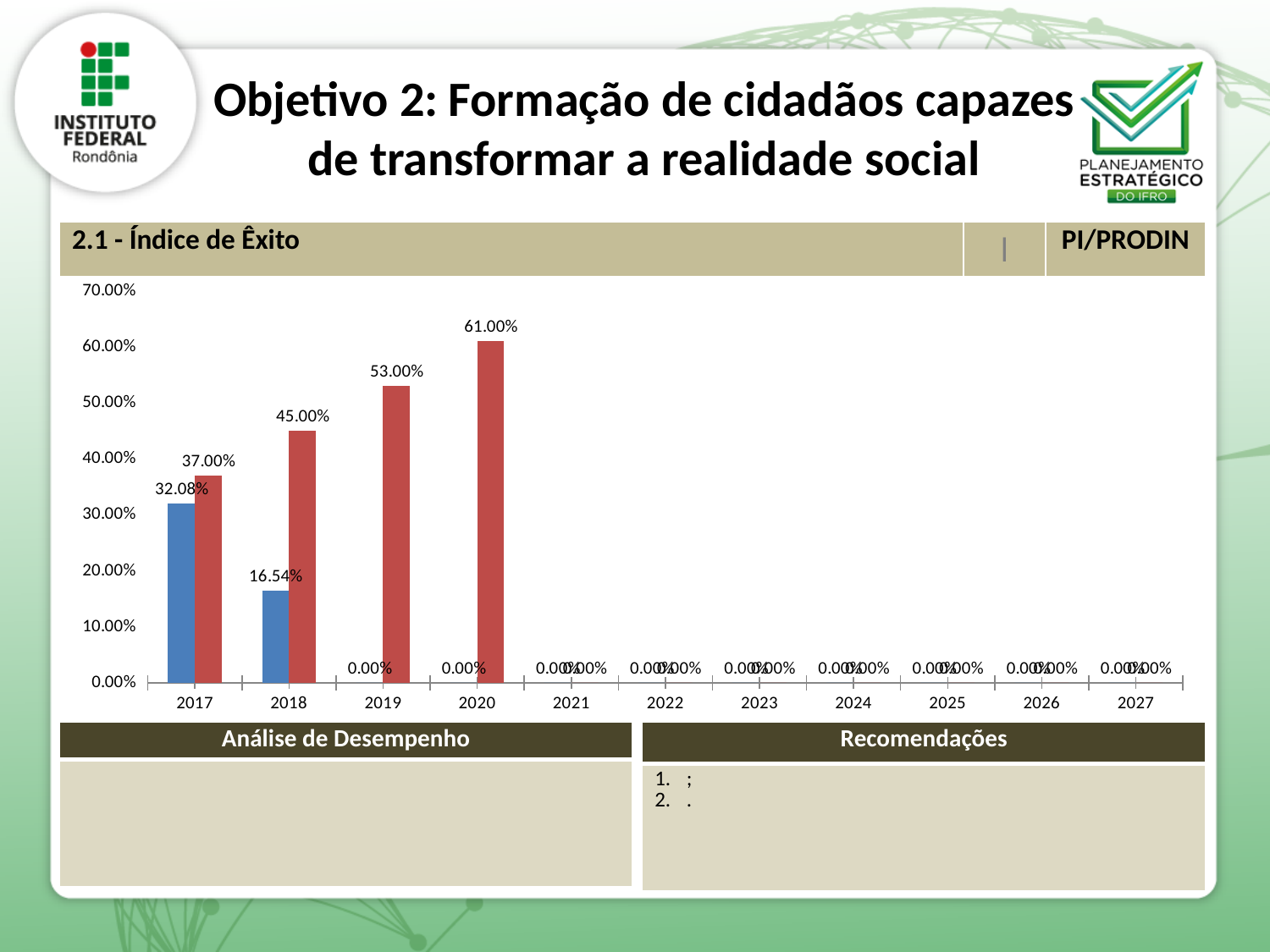
In 2018, which bar is larger, the blue one or the red one? the red one In 2017, how much larger is the red bar than the blue bar? 4.92% Do the red bar values rise or fall from 2017 to 2020? rise What kind of chart is shown on the slide? bar chart What is the value of the blue bar for 2018? 16.54% What is the value of the red bar for 2019? 53.00% What is the value of the blue bar for 2017? 32.08% What is the difference between the red bar values for 2020 and 2017? 24.00% In which year does the red series reach its highest value? 2020 What is the value of the red bar for 2020? 61.00% How many years are shown on the x axis? 11 What is the value of the red bar for 2017? 37.00%